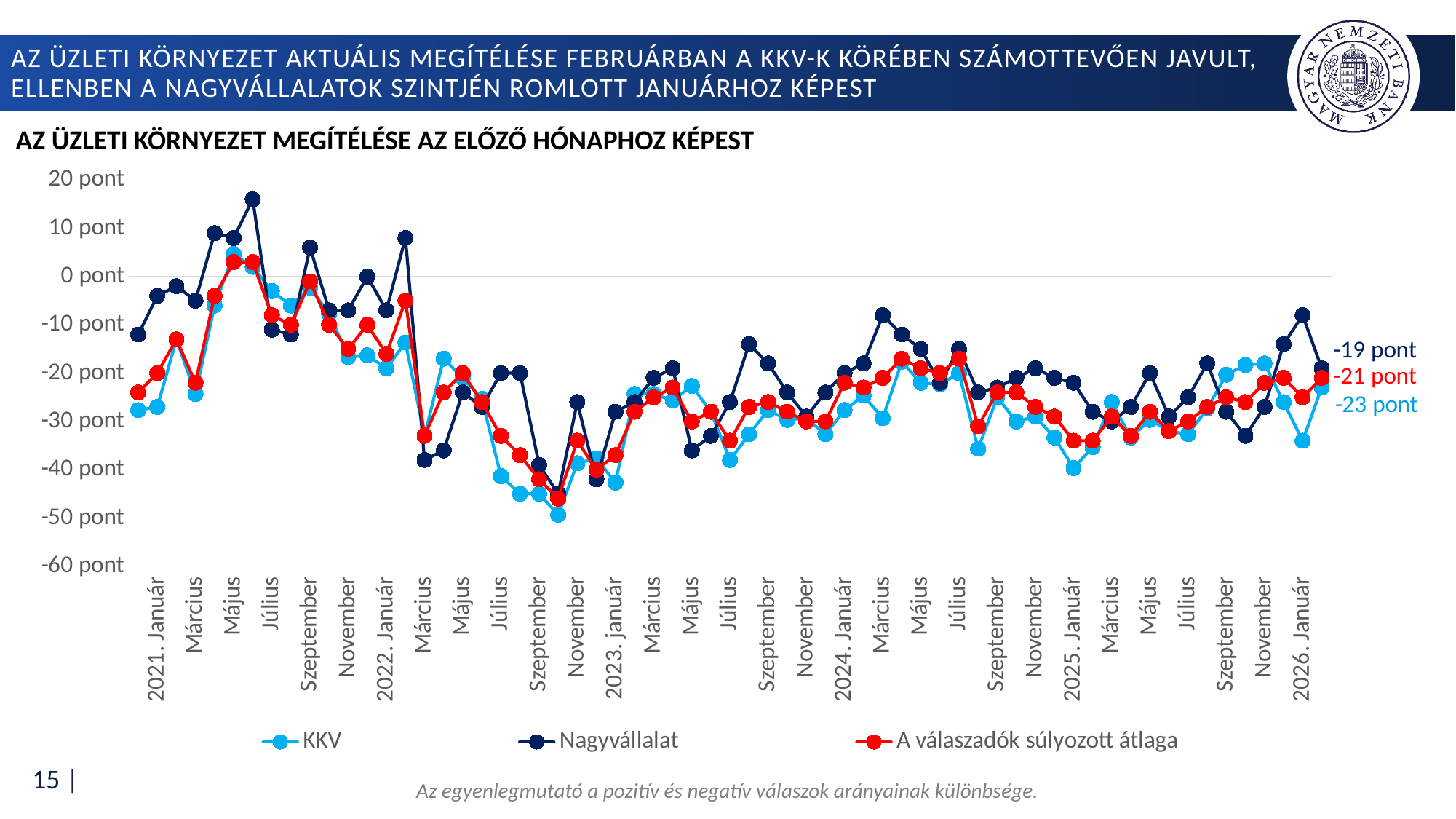
How many series does the legend list? 3 Between 2026. Január and the final data point, does the KKV line rise or fall? rise At the end of the series, which is higher: the Nagyvállalat value or the KKV value? Nagyvállalat Is the lowest value reached by the KKV series greater or less than -40 pont? less Is the highest value reached by the Nagyvállalat series greater or less than 10 pont? greater What kind of chart is shown on the slide? line chart What is the latest value labelled for the Nagyvállalat series? -19 pont What is the title of the chart? AZ ÜZLETI KÖRNYEZET MEGÍTÉLÉSE AZ ELŐZŐ HÓNAPHOZ KÉPEST What is the latest value labelled for 'A válaszadók súlyozott átlaga'? -21 pont Which series has the highest value at the final data point? Nagyvállalat What is the difference between the latest labelled Nagyvállalat value and the latest labelled KKV value? 4 pont What is the latest value labelled for the KKV series? -23 pont